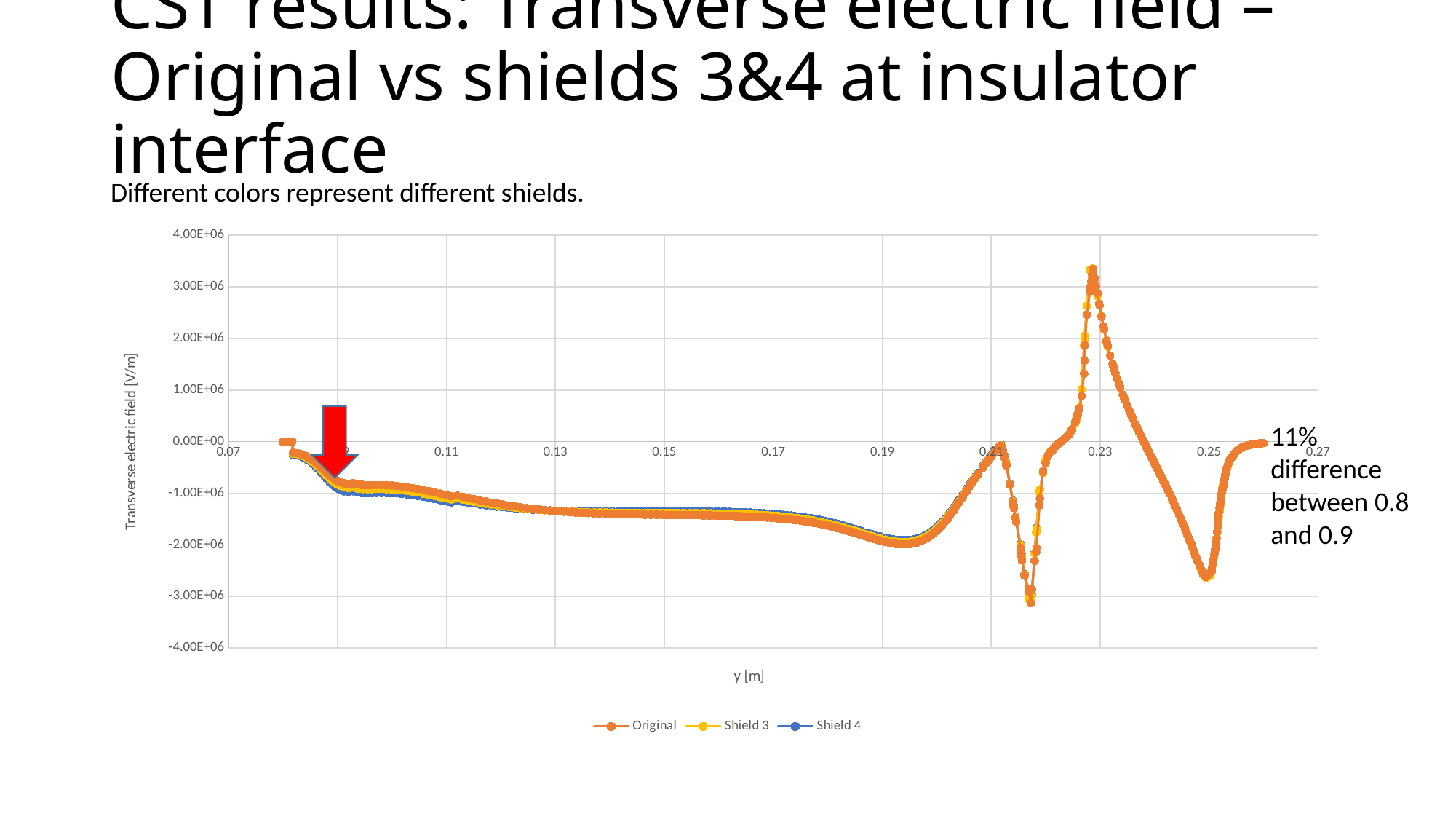
What is the highest value shown on the y axis? 4.00E+06 Do the curves rise or fall as y increases from 0.07 m to 0.19 m? fall What is the lowest value shown on the y axis? -4.00E+06 How many series does the legend list? 3 Is the value of the curves at y = 0.15 m greater or less than -1.00E+06? less What is the label of the y axis? Transverse electric field [V/m] Is the lowest value of the curves near y = 0.22 m greater or less than -2.00E+06? less What kind of chart is shown on the slide? Line chart Is the value of the curves at y = 0.25 m greater or less than -2.00E+06? less